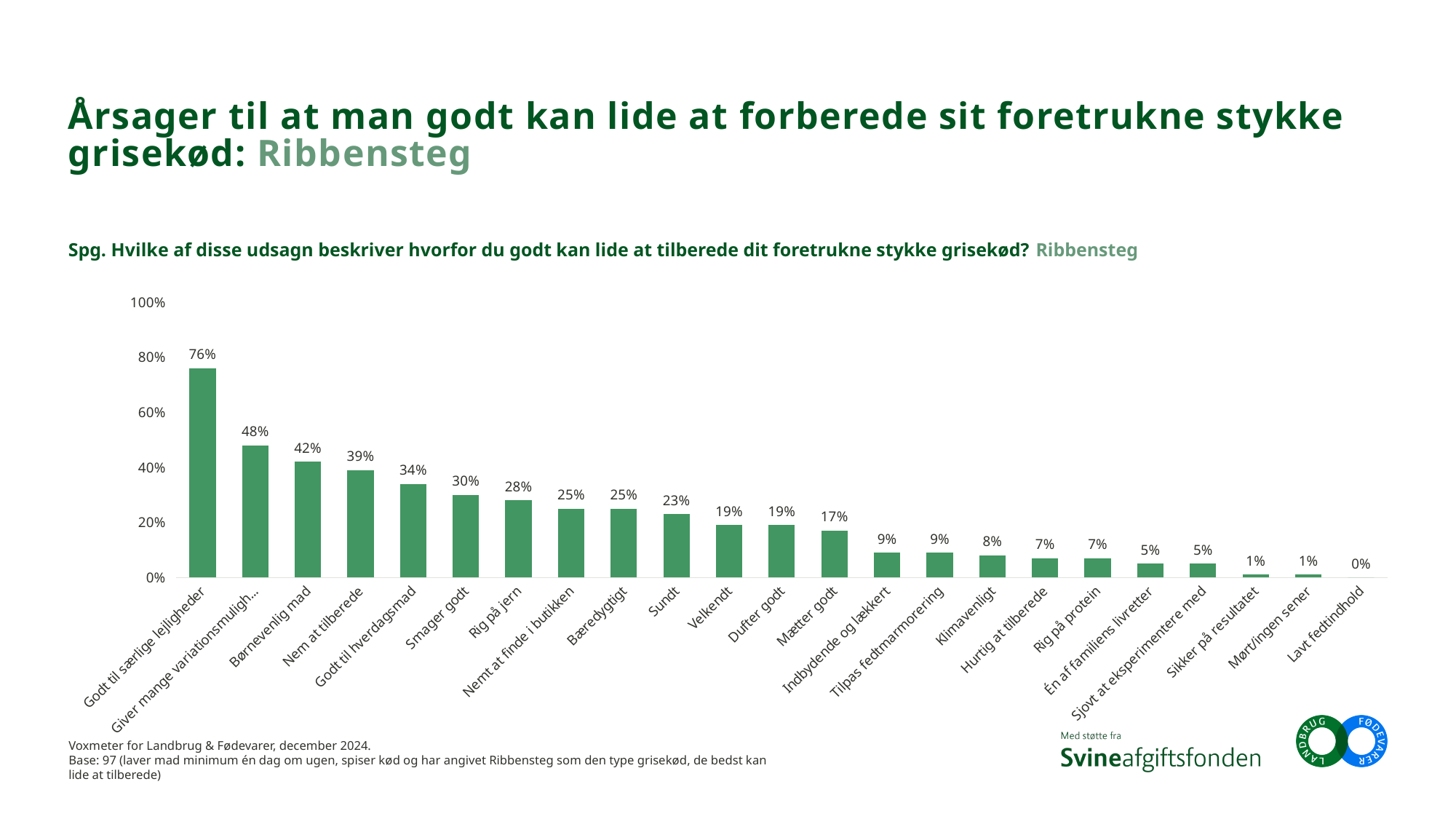
Is the value for "Godt til hverdagsmad" greater or less than 40%? less What is the value for "Smager godt"? 30% Which category has the lowest value? Lavt fedtindhold Do the values rise or fall from left to right along the x axis? Fall Which is larger, "Sundt" or "Mætter godt"? Sundt What is the value for "Børnevenlig mad"? 42% What kind of chart is shown on the slide? Bar chart Which category has the highest value? Godt til særlige lejligheder What is the value for "Godt til særlige lejligheder"? 76% How many categories are shown in the chart? 23 What is the value for "Klimavenligt"? 8% What is the difference between "Godt til særlige lejligheder" and "Nem at tilberede"? 37%